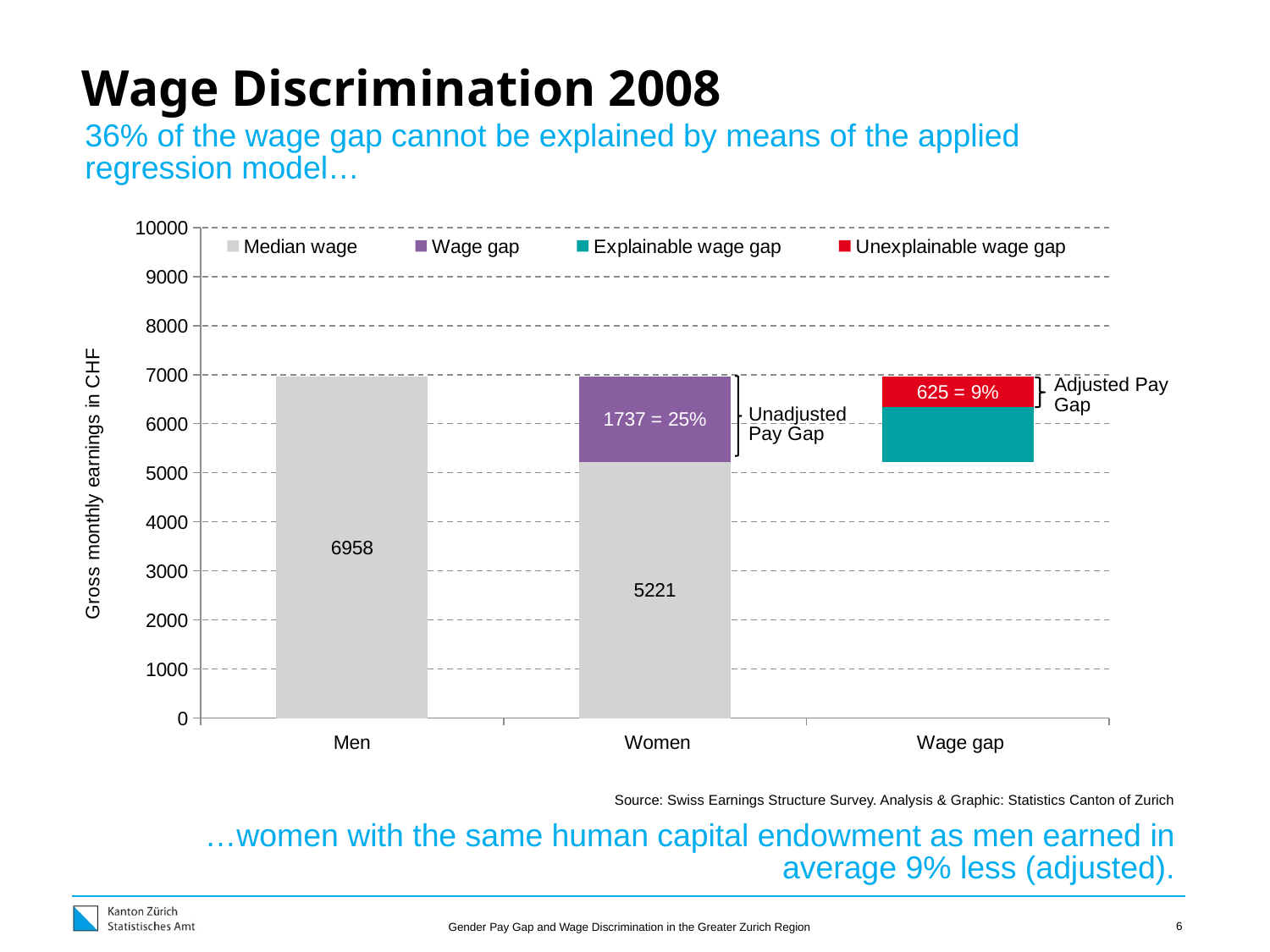
How many series does the chart legend list? 4 Is the median wage for Men greater or less than 7000? less What is the total height of the stacked Women bar (median wage plus wage gap)? 6958 What is the median wage for Men shown in the chart? 6958 What value is labelled on the Unexplainable wage gap segment of the Wage gap bar? 625 = 9% What kind of chart is shown on the slide? Stacked bar chart How many categories are shown on the x axis of the chart? 3 What is the label on the y axis of the chart? Gross monthly earnings in CHF What is the median wage for Women shown in the chart? 5221 What is the difference between the median wage for Men and the median wage for Women? 1737 What value is labelled on the Wage gap segment of the Women bar? 1737 = 25% Which has the larger median wage, Men or Women? Men